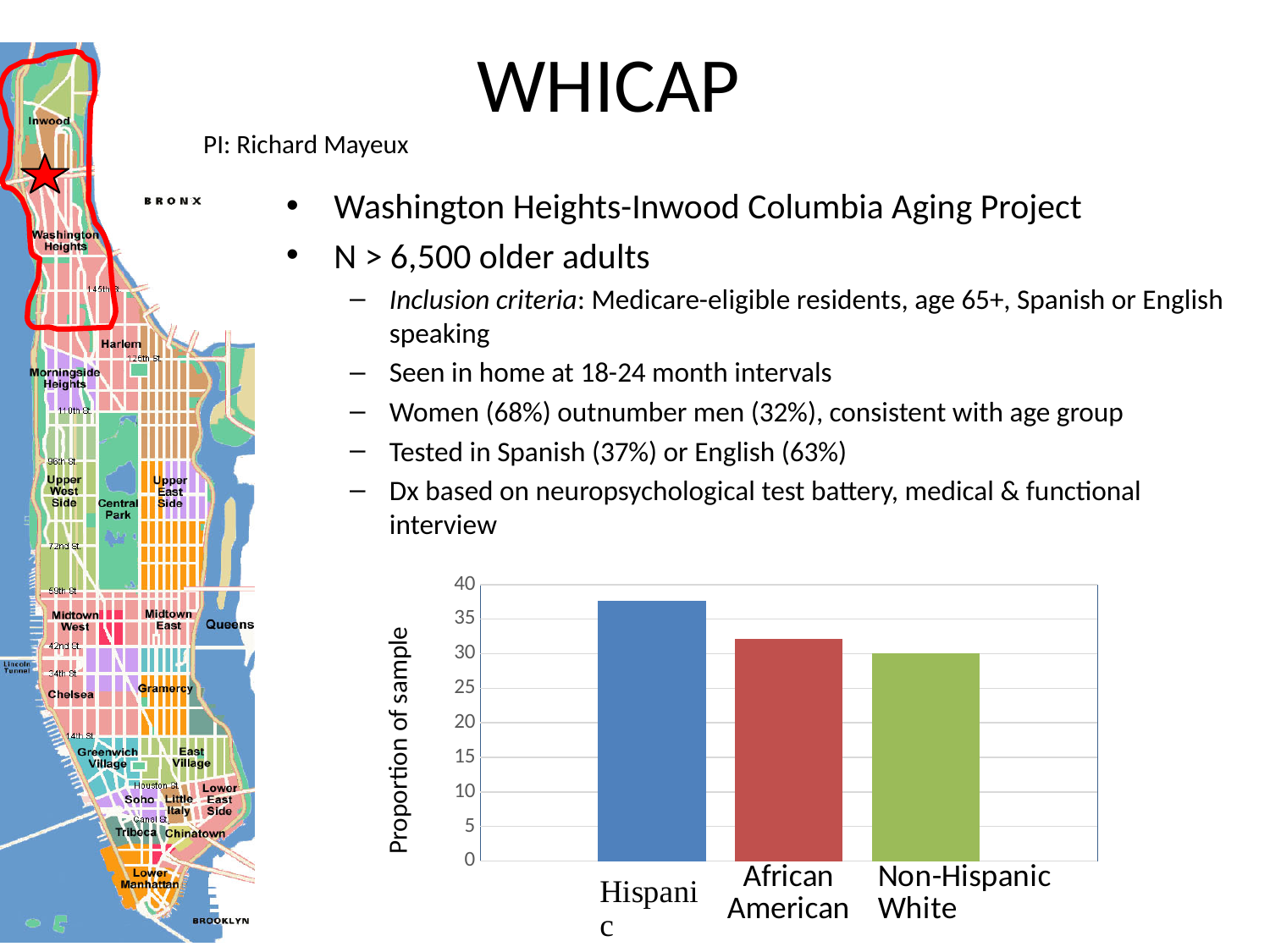
Is the value for Non-Hispanic White greater or less than 25? greater What is the label on the vertical axis of the bar chart? Proportion of sample Is the value for Hispanic greater or less than 35? greater Which category has the highest proportion of sample in the bar chart? Hispanic Is the value for Hispanic greater or less than 40? less How many categories are plotted in the bar chart? 3 Do the bar values rise or fall from left to right across the categories? fall What kind of chart is shown on the slide? bar chart Which is larger in the bar chart, the value for Hispanic or the value for African American? Hispanic Which category has the lowest proportion of sample in the bar chart? Non-Hispanic White